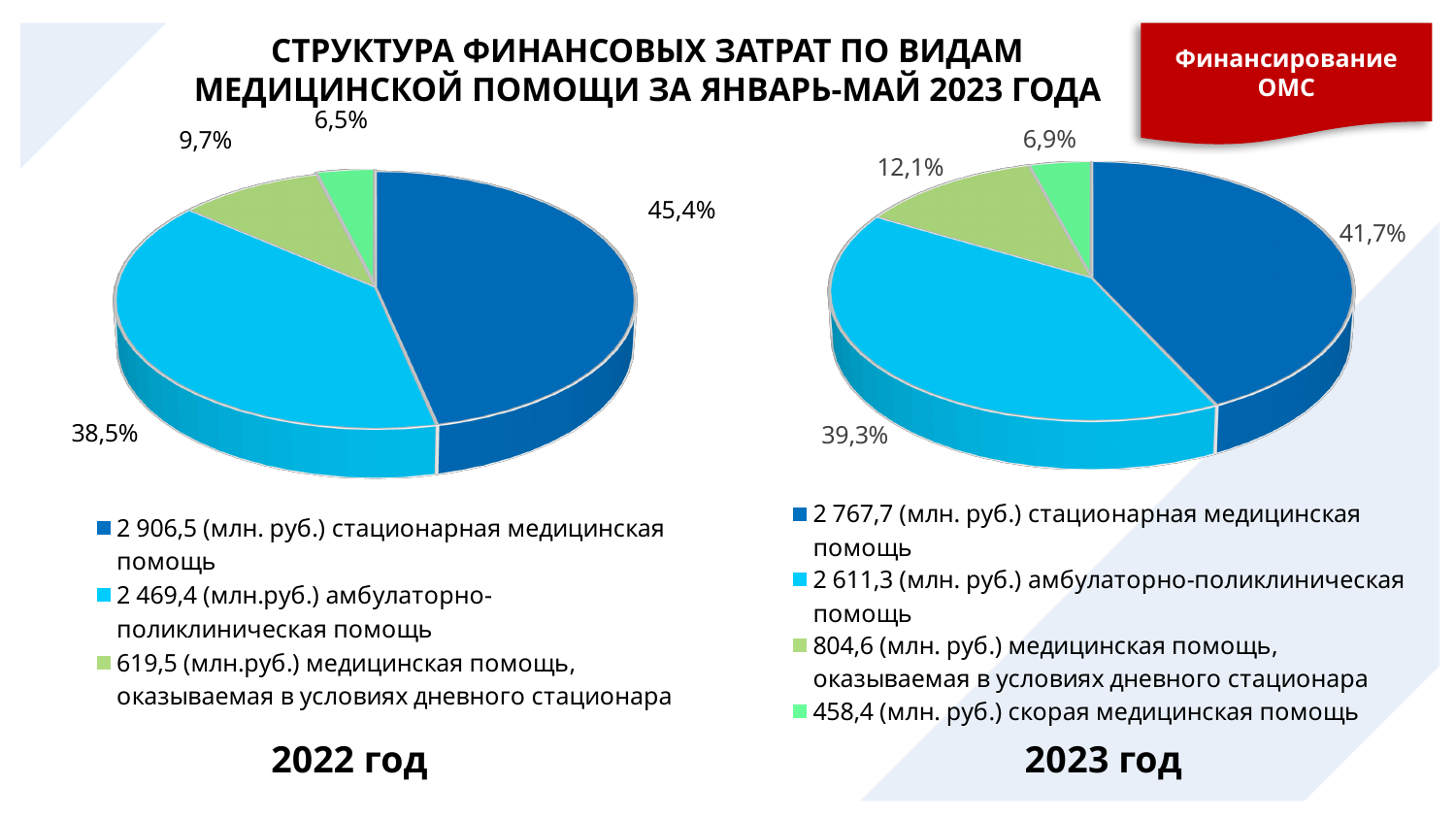
Which is larger: the share of медицинская помощь, оказываемая в условиях дневного стационара in the 2022 год chart or in the 2023 год chart? 2023 год In the 2023 год pie chart, what is the difference in percentage points between the стационарная медицинская помощь share (41,7%) and the амбулаторно-поликлиническая помощь share (39,3%)? 2,4 In the 2023 год chart legend, what value in млн. руб. is given for скорая медицинская помощь? 458,4 In the 2023 год pie chart, which category has the smallest share? скорая медицинская помощь In the 2022 год pie chart, which category has the largest share? стационарная медицинская помощь In the 2023 год pie chart, what share is labelled for амбулаторно-поликлиническая помощь? 39,3% In the 2022 год pie chart, what share is labelled for the largest slice (стационарная медицинская помощь)? 45,4% How many entries does the legend of the 2023 год chart list? 4 In the 2023 год chart legend, what value in млн. руб. is given for медицинская помощь, оказываемая в условиях дневного стационара? 804,6 What kind of chart is used for the 2022 год data on the left? pie chart In the 2022 год chart legend, what value in млн. руб. is given for стационарная медицинская помощь? 2 906,5 How many slices does the 2022 год pie chart have? 4